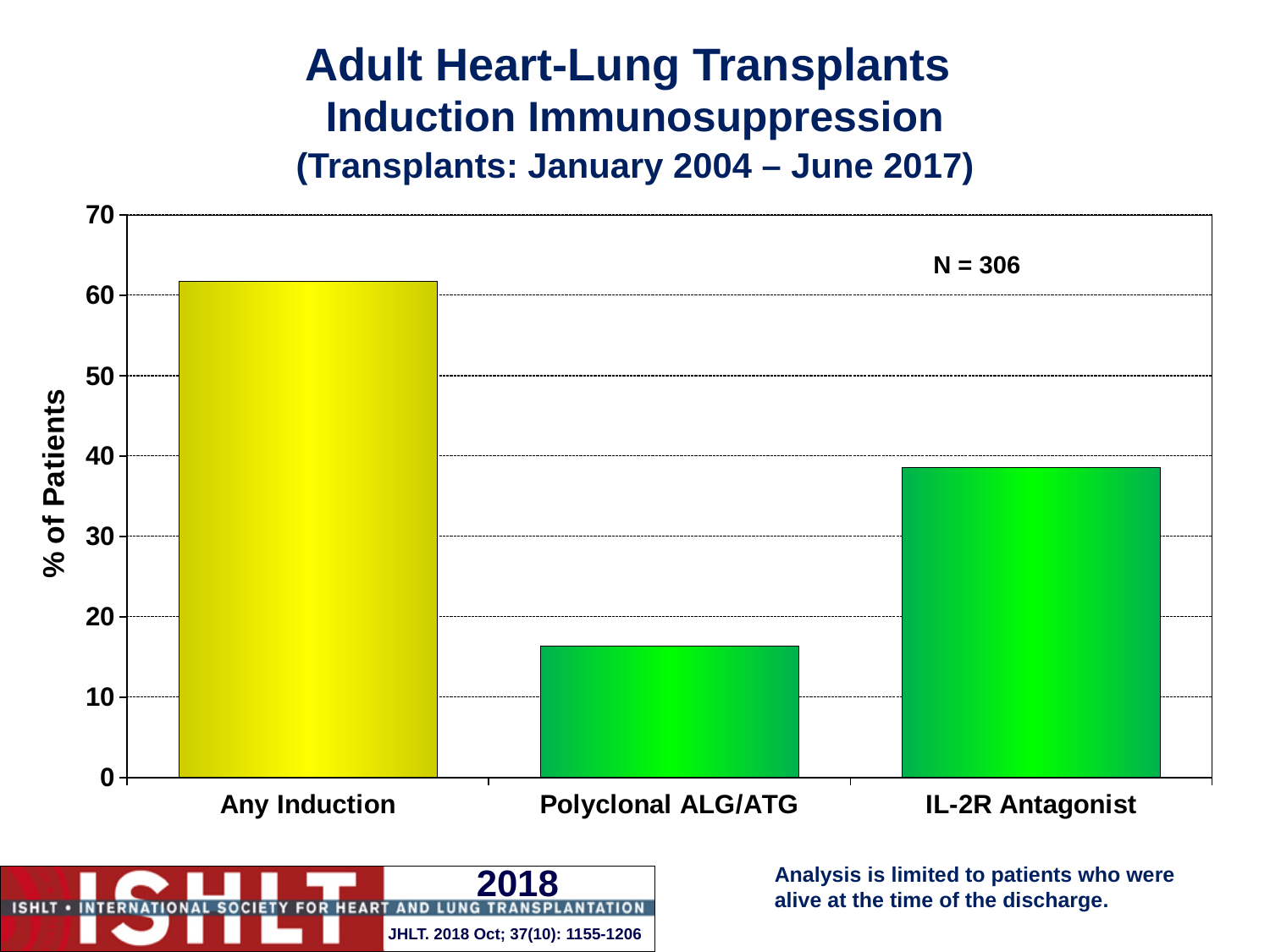
Is the value for IL-2R Antagonist greater or less than 30? greater Is the value for Polyclonal ALG/ATG greater or less than 20? less Which is larger, the value for IL-2R Antagonist or the value for Polyclonal ALG/ATG? IL-2R Antagonist How many categories are shown on the x axis of the chart? 3 What is the label of the y axis? % of Patients Which category has the highest % of patients? Any Induction What sample size (N) is shown on the chart? N = 306 Which category has the lowest % of patients? Polyclonal ALG/ATG Is the value for IL-2R Antagonist greater or less than 40? less What kind of chart is shown on the slide? bar chart